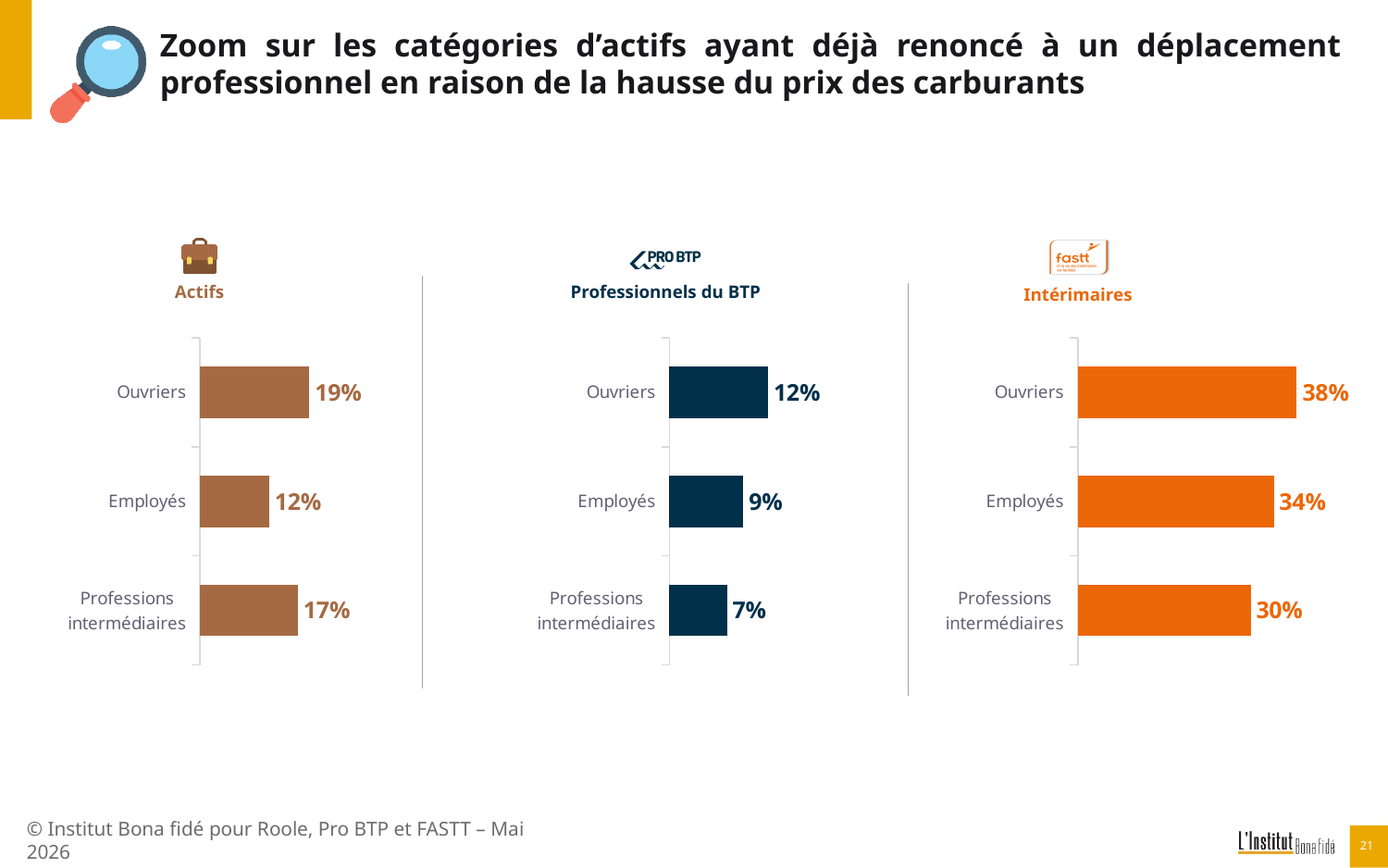
In the Actifs chart, what is the difference between the values for Ouvriers and Employés? 7% In the Intérimaires chart, which category has the highest value? Ouvriers What kind of chart is the Actifs chart? Bar chart In the Actifs chart, which category has the lowest value? Employés In the Professionnels du BTP chart, which category has the lowest value? Professions intermédiaires In the Professionnels du BTP chart, which is larger: the value for Ouvriers or the value for Professions intermédiaires? Ouvriers In the Intérimaires chart, what is the difference between the values for Ouvriers and Professions intermédiaires? 8% In the Actifs chart, what is the value for Ouvriers? 19% In the Intérimaires chart, what is the value for Professions intermédiaires? 30% What colour are the bars in the Intérimaires chart? Orange How many categories are shown in the Intérimaires chart? 3 In the Professionnels du BTP chart, what is the value for Employés? 9%